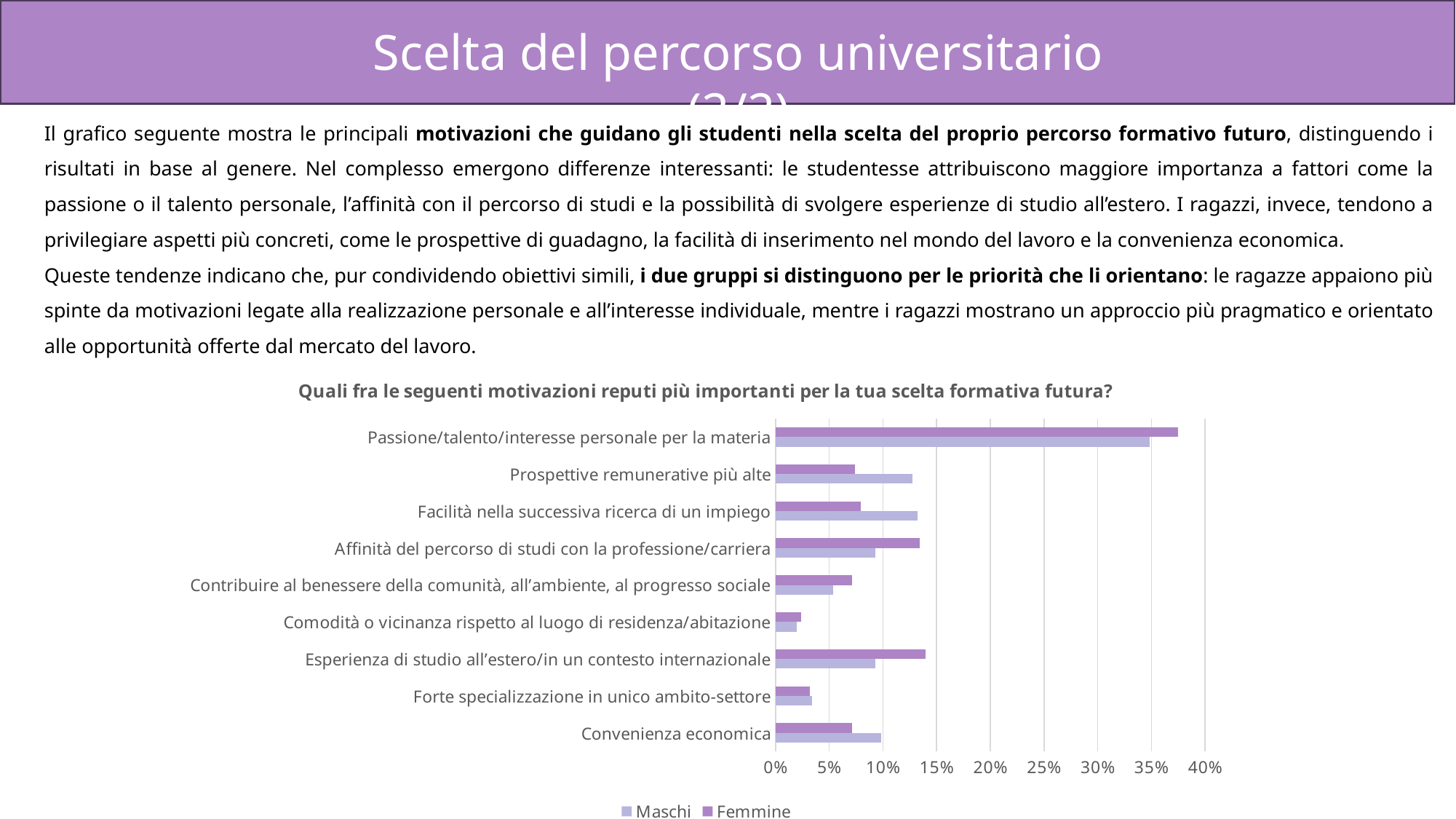
For Facilità nella successiva ricerca di un impiego, which series has the larger value, Maschi or Femmine? Maschi How many motivation categories are plotted in the chart? 9 Which category has the highest value for Femmine? Passione/talento/interesse personale per la materia Is the Femmine value for Passione/talento/interesse personale per la materia greater or less than 35%? greater Which category has the lowest value for Maschi? Comodità o vicinanza rispetto al luogo di residenza/abitazione What are the two series names listed in the chart legend? Maschi and Femmine For Esperienza di studio all'estero/in un contesto internazionale, which series has the larger value, Maschi or Femmine? Femmine Is the Maschi value for Prospettive remunerative più alte greater or less than 10%? greater What kind of chart is shown on the slide? bar chart Is the Femmine value for Comodità o vicinanza rispetto al luogo di residenza/abitazione greater or less than 5%? less For Convenienza economica, which series has the larger value, Maschi or Femmine? Maschi How many series does the legend of the chart list? 2